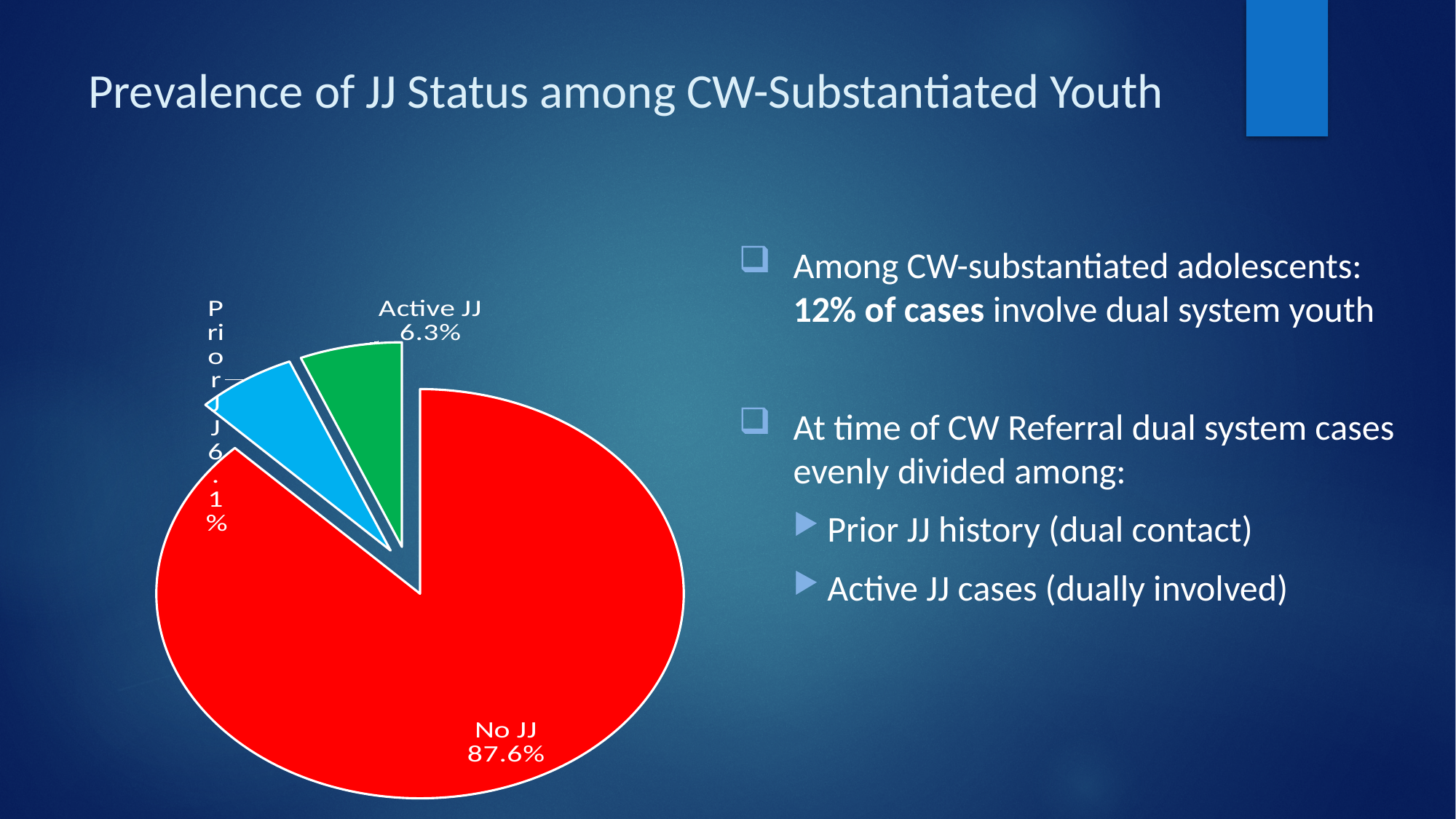
What percentage of the pie chart is labelled Active JJ? 6.3% Which slice of the pie chart is the smallest? Prior JJ What is the difference in percentage points between the Active JJ slice and the Prior JJ slice? 0.2 What percentage of the pie chart is labelled Prior JJ? 6.1% What colour is the Active JJ slice of the pie chart? green What type of chart is shown on the slide? pie chart What is the difference in percentage points between the No JJ slice and the Active JJ slice? 81.3 Which is larger in the pie chart, the No JJ slice or the Active JJ slice? No JJ What colour is the No JJ slice of the pie chart? red What percentage of the pie chart is labelled No JJ? 87.6% Which slice of the pie chart is the largest? No JJ How many slices does the pie chart have? 3